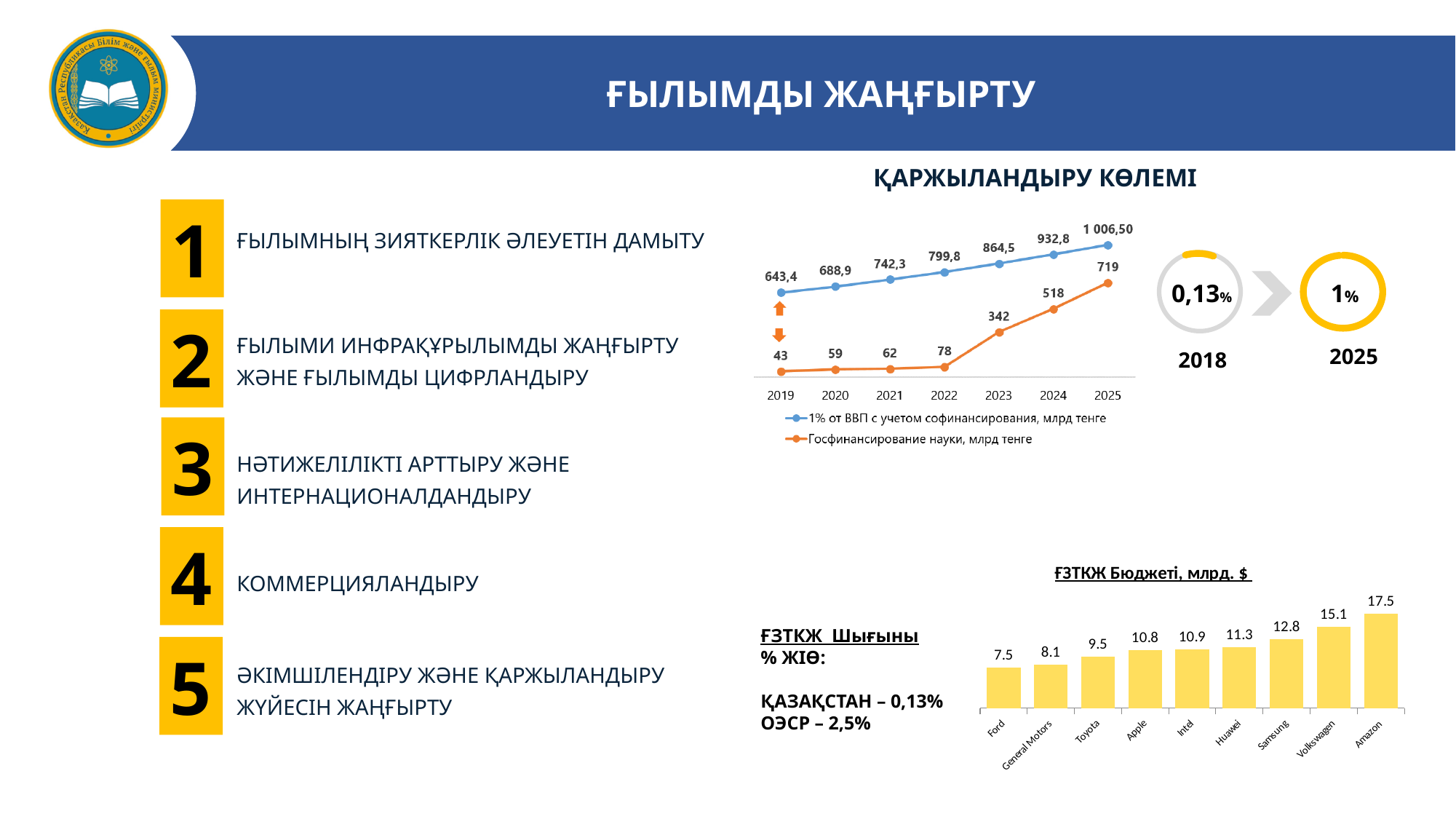
In the line chart titled ҚАРЖЫЛАНДЫРУ КӨЛЕМІ, does 'Госфинансирование науки, млрд тенге' rise or fall from 2019 to 2025? rise In the bar chart titled ҒЗТКЖ Бюджеті, млрд. $, which is larger, the value for Toyota or the value for Huawei? Huawei In the line chart titled ҚАРЖЫЛАНДЫРУ КӨЛЕМІ, in which year is 'Госфинансирование науки, млрд тенге' lowest? 2019 In the line chart titled ҚАРЖЫЛАНДЫРУ КӨЛЕМІ, how many series does the legend list? 2 In the bar chart titled ҒЗТКЖ Бюджеті, млрд. $, what is the value for Samsung? 12.8 In the line chart titled ҚАРЖЫЛАНДЫРУ КӨЛЕМІ, what is the value of '1% от ВВП с учетом софинансирования, млрд тенге' for 2025? 1 006,50 In the line chart titled ҚАРЖЫЛАНДЫРУ КӨЛЕМІ, what is the difference between 'Госфинансирование науки, млрд тенге' in 2025 and in 2024? 201 In the line chart titled ҚАРЖЫЛАНДЫРУ КӨЛЕМІ, what is the value of 'Госфинансирование науки, млрд тенге' for 2023? 342 In the bar chart titled ҒЗТКЖ Бюджеті, млрд. $, which company has the highest value? Amazon In the line chart titled ҚАРЖЫЛАНДЫРУ КӨЛЕМІ, how many years are shown on the x axis? 7 In the line chart titled ҚАРЖЫЛАНДЫРУ КӨЛЕМІ, what is the value of the series '1% от ВВП с учетом софинансирования, млрд тенге' for 2019? 643,4 What kind of chart is the one titled ҒЗТКЖ Бюджеті, млрд. $? bar chart